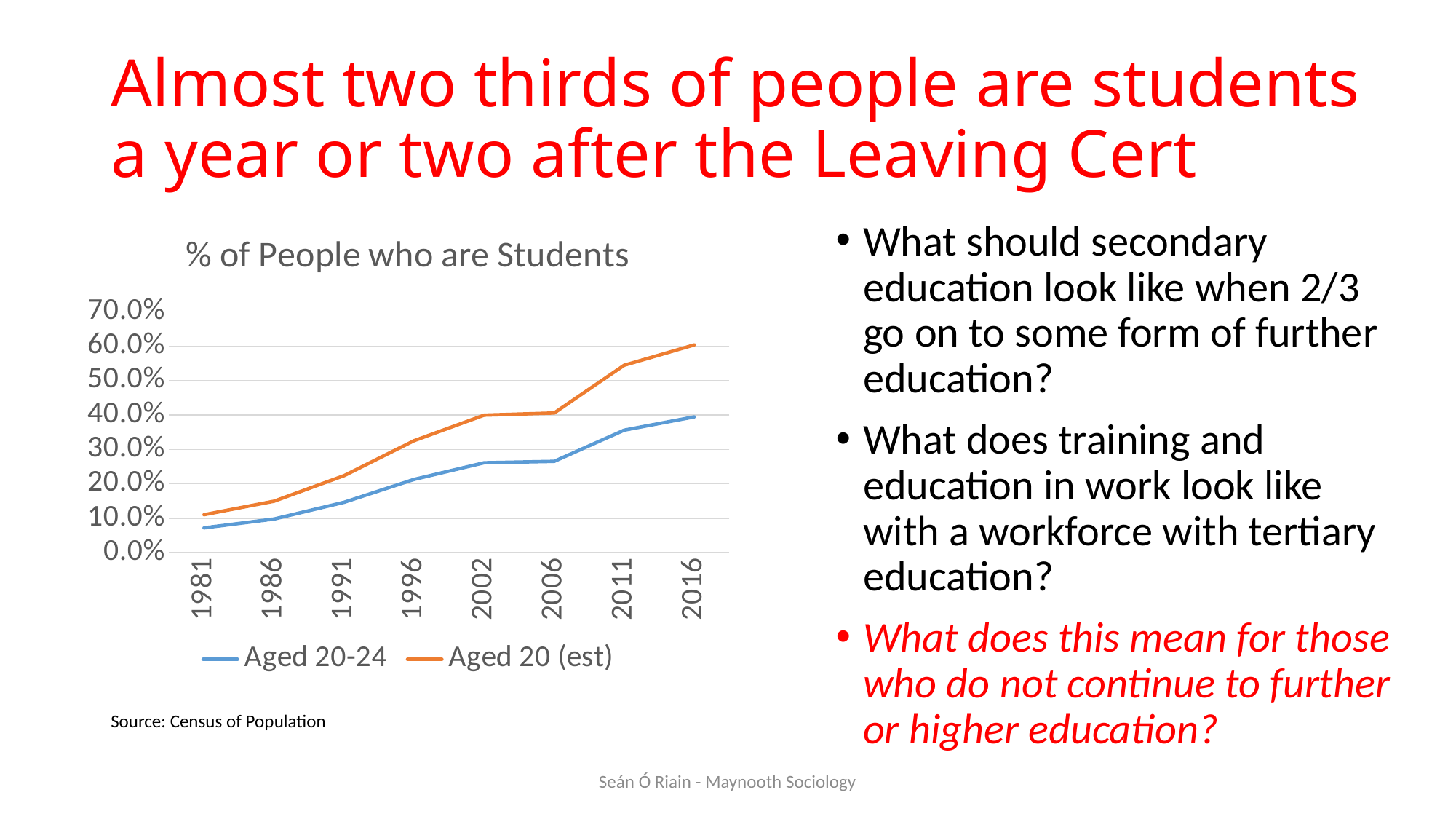
Which colour is used for the Aged 20 (est) line? orange In which year is the value for Aged 20-24 lowest? 1981 Is the value for Aged 20-24 in 1981 greater or less than 10.0%? less Is the value for Aged 20 (est) in 2016 greater or less than 50.0%? greater In which year is the value for Aged 20 (est) highest? 2016 Do the values for Aged 20-24 rise or fall from 1981 to 2016? rise How many years are shown along the x axis of the chart? 8 How many series does the chart's legend list? 2 Is the value for Aged 20-24 in 2011 greater or less than 30.0%? greater In 2016, which series has the larger value, Aged 20-24 or Aged 20 (est)? Aged 20 (est) What kind of chart is shown on the slide? line chart What is the title of the chart? % of People who are Students